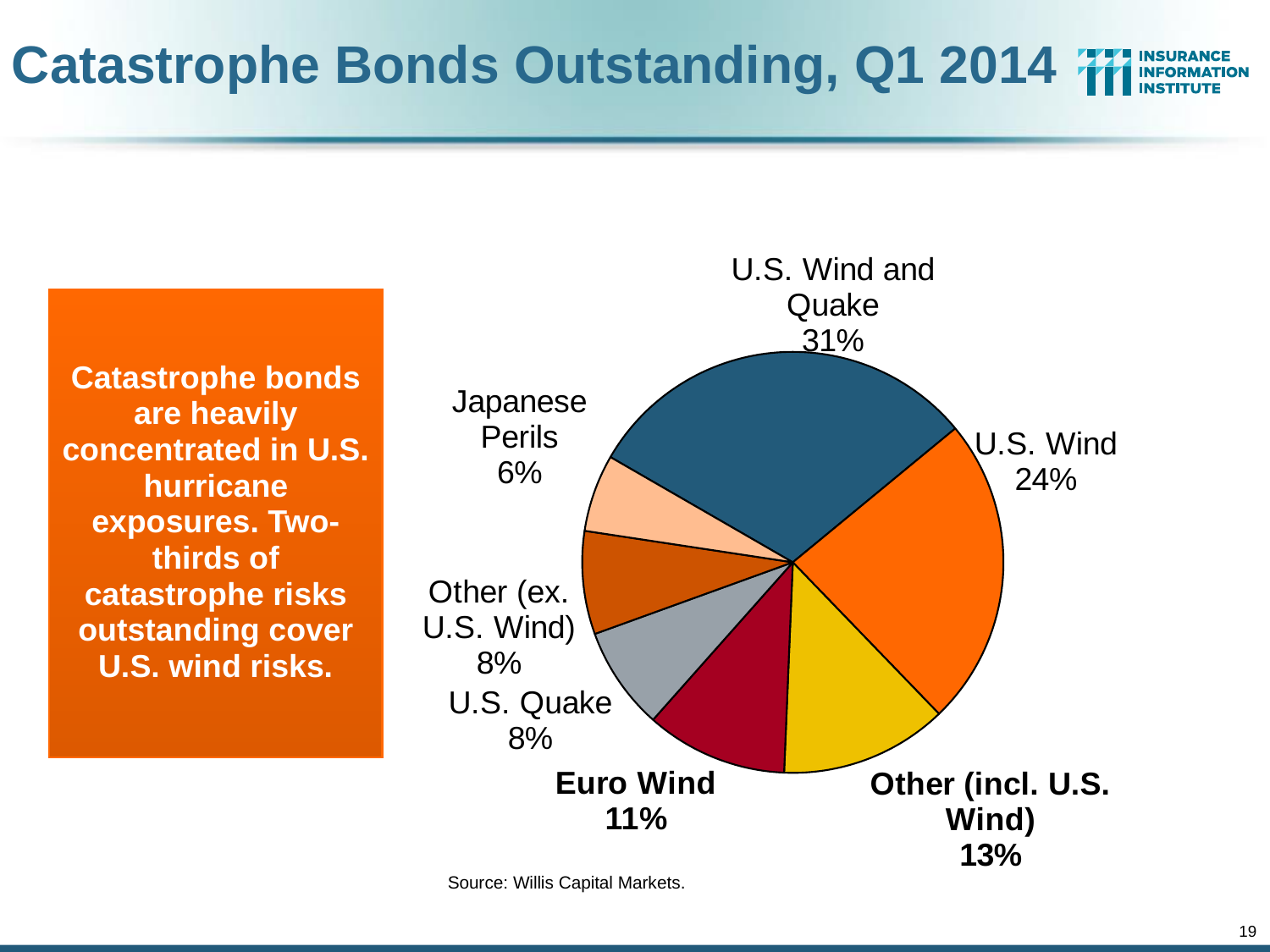
What percentage is shown for Japanese Perils? 6% What percentage is shown for Euro Wind? 11% Which category has the smallest share of the pie? Japanese Perils How many slices does the pie chart have? 7 What is the difference in percentage points between U.S. Wind and Quake and U.S. Wind? 7 percentage points What share is Other (incl. U.S. Wind)? 13% What is the source cited for the chart? Willis Capital Markets What share of the pie is U.S. Wind? 24% Which is larger, Euro Wind or Other (incl. U.S. Wind)? Other (incl. U.S. Wind) Which category has the largest share of the pie? U.S. Wind and Quake What kind of chart is shown on the slide? Pie chart What share of catastrophe bonds outstanding is U.S. Wind and Quake? 31%